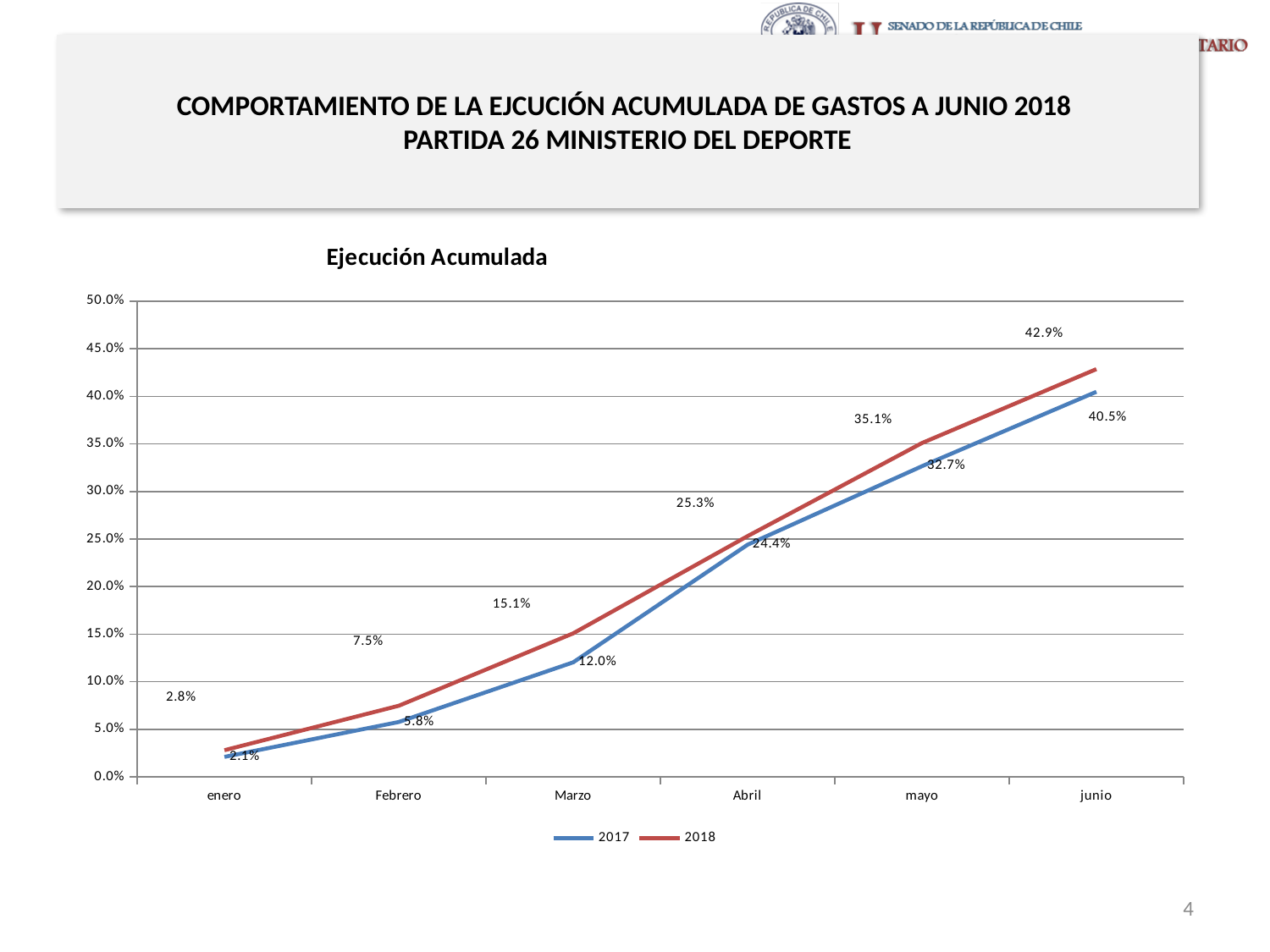
What is the value for 2018 in junio? 42.9% What is the value for 2017 in Marzo? 12.0% What kind of chart is shown on the slide? line chart How many months are shown on the x axis? 6 In which month is the 2018 series lowest? enero What is the value for 2018 in Abril? 25.3% Which series has the larger value in Febrero, 2017 or 2018? 2018 What is the value for 2017 in enero? 2.1% What is the difference between the 2018 and 2017 values in mayo? 2.4% Do the values for 2017 rise or fall from enero to junio? rise In which month is the 2017 series highest? junio How many series does the legend list? 2